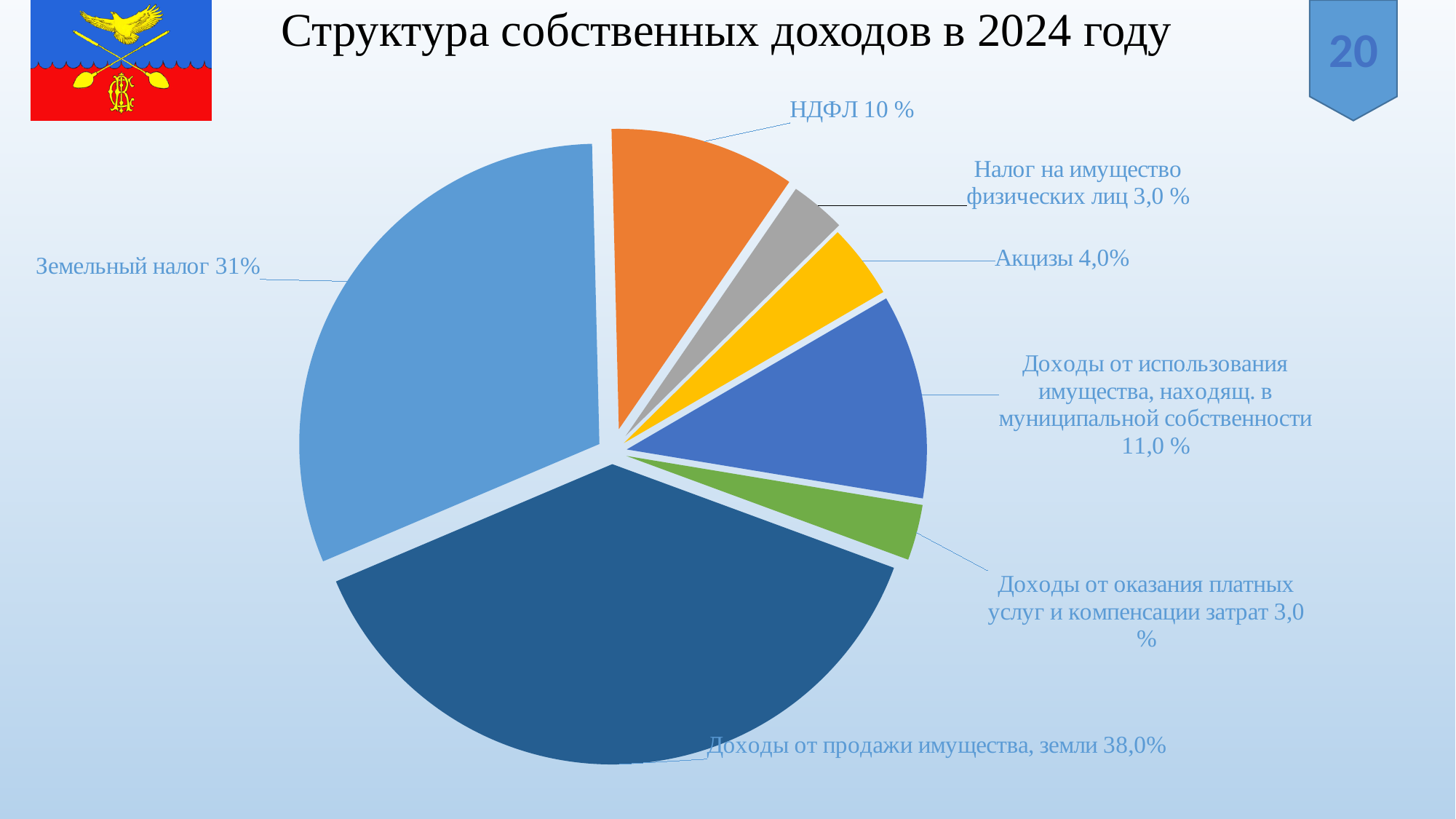
What is the difference in percentage points between Доходы от продажи имущества, земли and Земельный налог? 7 What is the title of the chart? Структура собственных доходов в 2024 году What share does НДФЛ have in the pie chart? 10 % What share is shown for Налог на имущество физических лиц? 3,0 % What share is shown for Земельный налог? 31% What share is shown for Акцизы? 4,0% Which is larger: the share for НДФЛ or the share for Акцизы? НДФЛ What kind of chart is shown on the slide? pie chart Which category has the largest share of the pie? Доходы от продажи имущества, земли Which is larger: the share for Земельный налог or the share for Доходы от использования имущества, находящ. в муниципальной собственности? Земельный налог How many slices does the pie chart have? 7 What share is shown for Доходы от использования имущества, находящ. в муниципальной собственности? 11,0 %